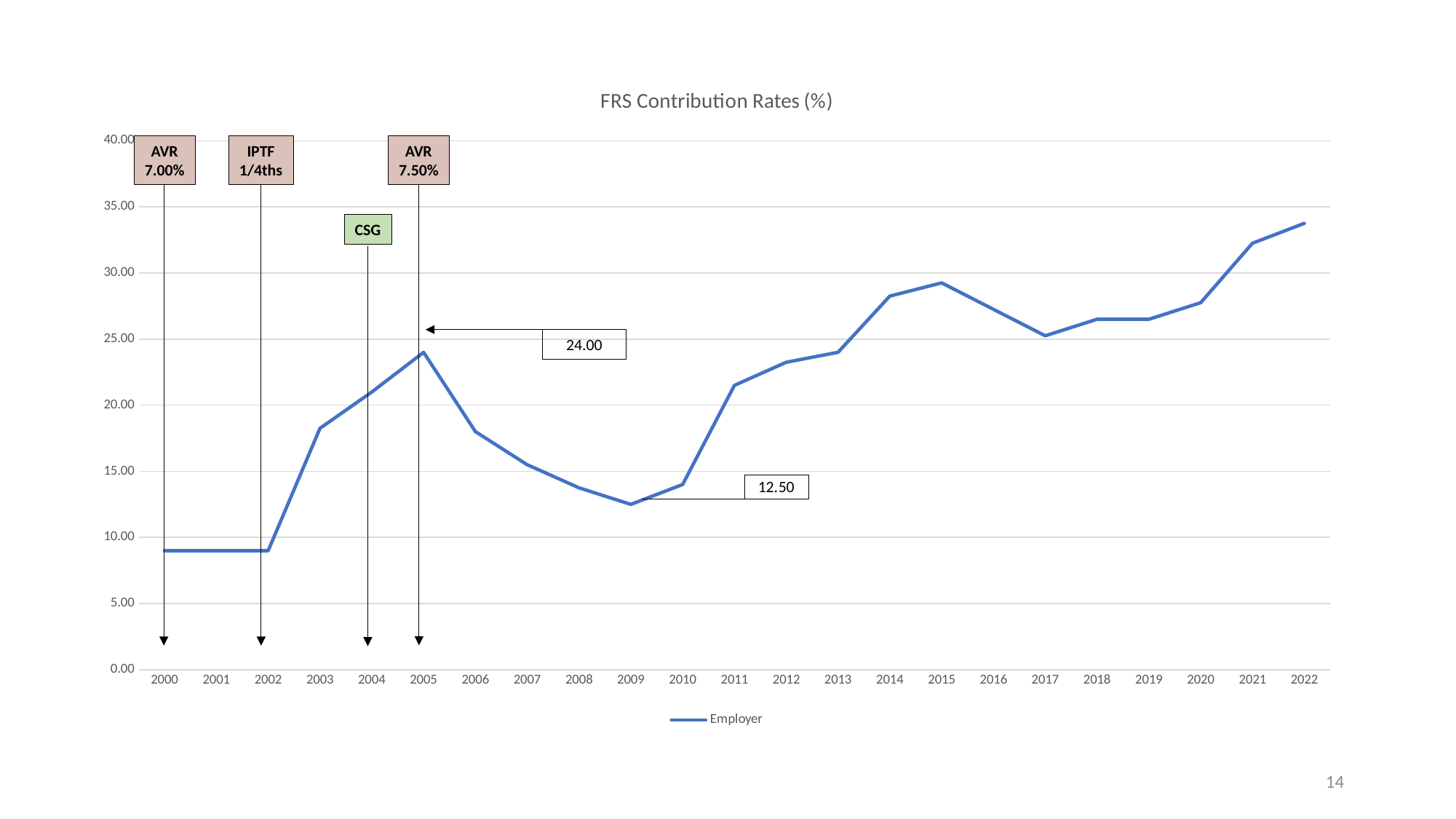
What kind of chart is shown on the slide? line chart How many years are plotted along the x axis? 23 Between 2005 and 2015, which year has the lowest Employer contribution rate? 2009 Does the Employer contribution rate rise or fall from 2005 to 2009? fall Which year has the highest Employer contribution rate? 2022 Is the value for 2022 greater or less than 30.00? greater What is the difference between the labelled values for 2005 and 2009? 11.50 What is the title of the chart? FRS Contribution Rates (%) How many series does the legend list? 1 Which year has the larger Employer contribution rate, 2015 or 2017? 2015 What is the Employer contribution rate labelled for 2009? 12.50 What is the Employer contribution rate labelled for 2005? 24.00